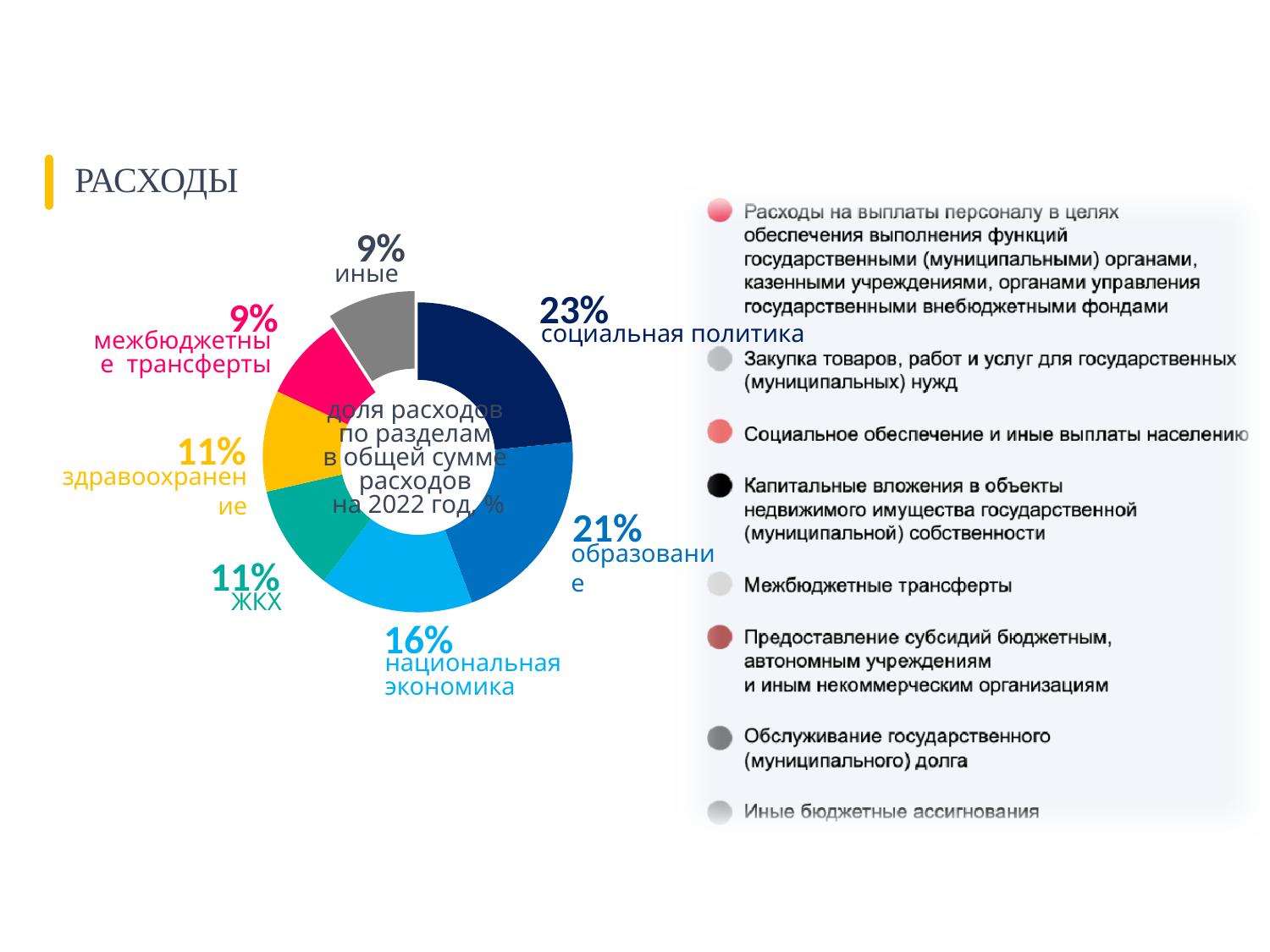
What share of expenditures goes to национальная экономика? 16% What share of expenditures goes to здравоохранение? 11% What is the difference in percentage points between социальная политика and образование? 2 What share of expenditures goes to образование? 21% What share of expenditures goes to социальная политика? 23% What share of expenditures goes to межбюджетные трансферты? 9% How many sections (slices) are shown in the donut chart? 7 What year does the chart's central text say the expenditure shares refer to? 2022 Which is larger: the share for национальная экономика or the share for ЖКХ? национальная экономика What is the difference in percentage points between образование and иные? 12 What kind of chart is shown on the slide? Donut (pie) chart Which section has the largest share of expenditures? социальная политика